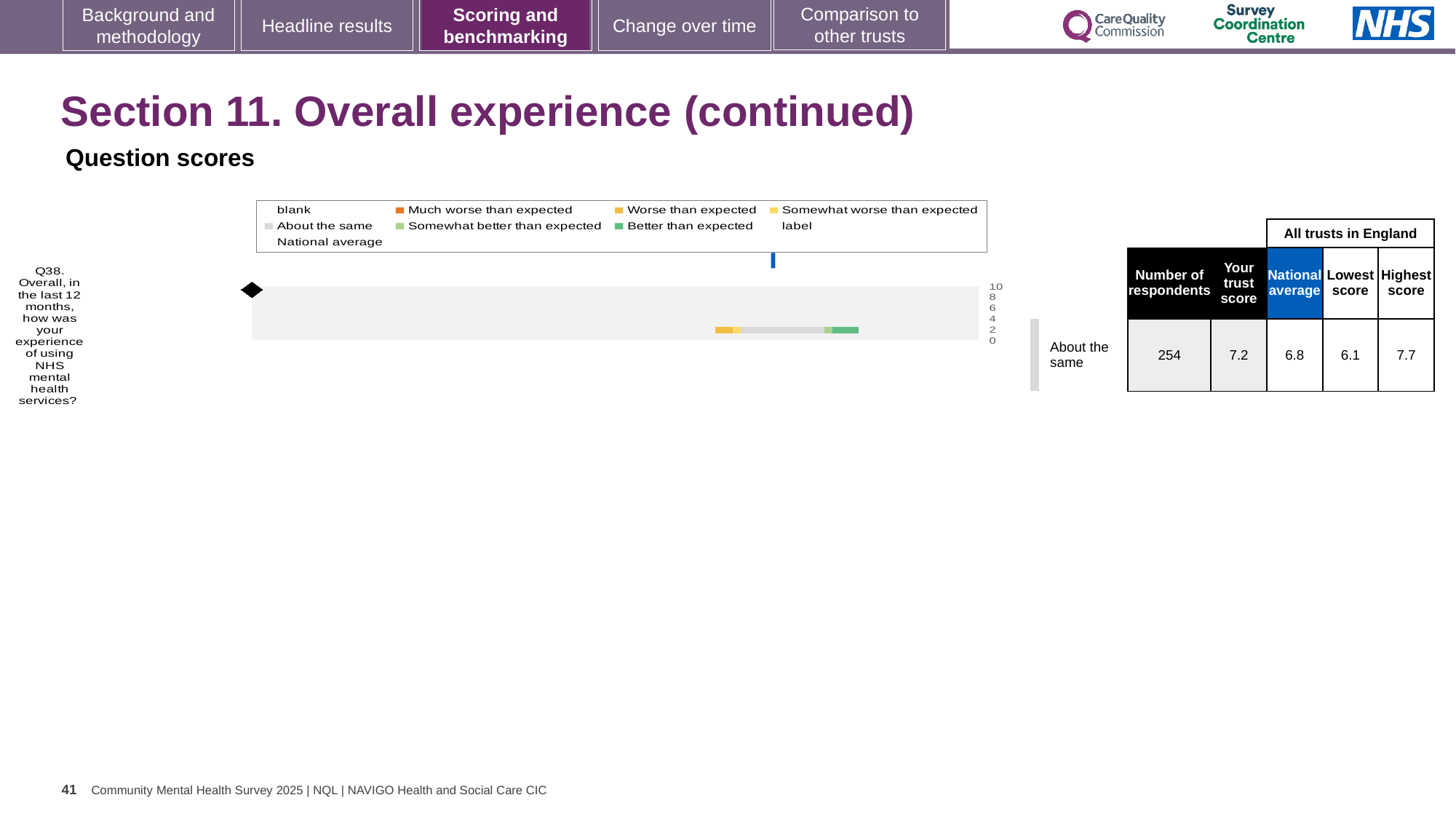
What is the lowest score among all trusts in England for Q38? 6.1 Which benchmarking category is Q38 assigned to, according to the label next to the chart? About the same What is the maximum value shown on the chart's score axis? 10 How many survey questions are plotted in the chart on this slide? 1 What kind of chart is shown on the slide for Q38? bar chart Which is larger for Q38, the trust's score or the national average? the trust's score What is the number of respondents for Q38? 254 What is the difference between the trust's score and the national average for Q38? 0.4 What is the difference between the highest and lowest scores among all trusts in England for Q38? 1.6 What is the national average score for Q38? 6.8 What is the highest score among all trusts in England for Q38? 7.7 What is the trust's score for Q38? 7.2